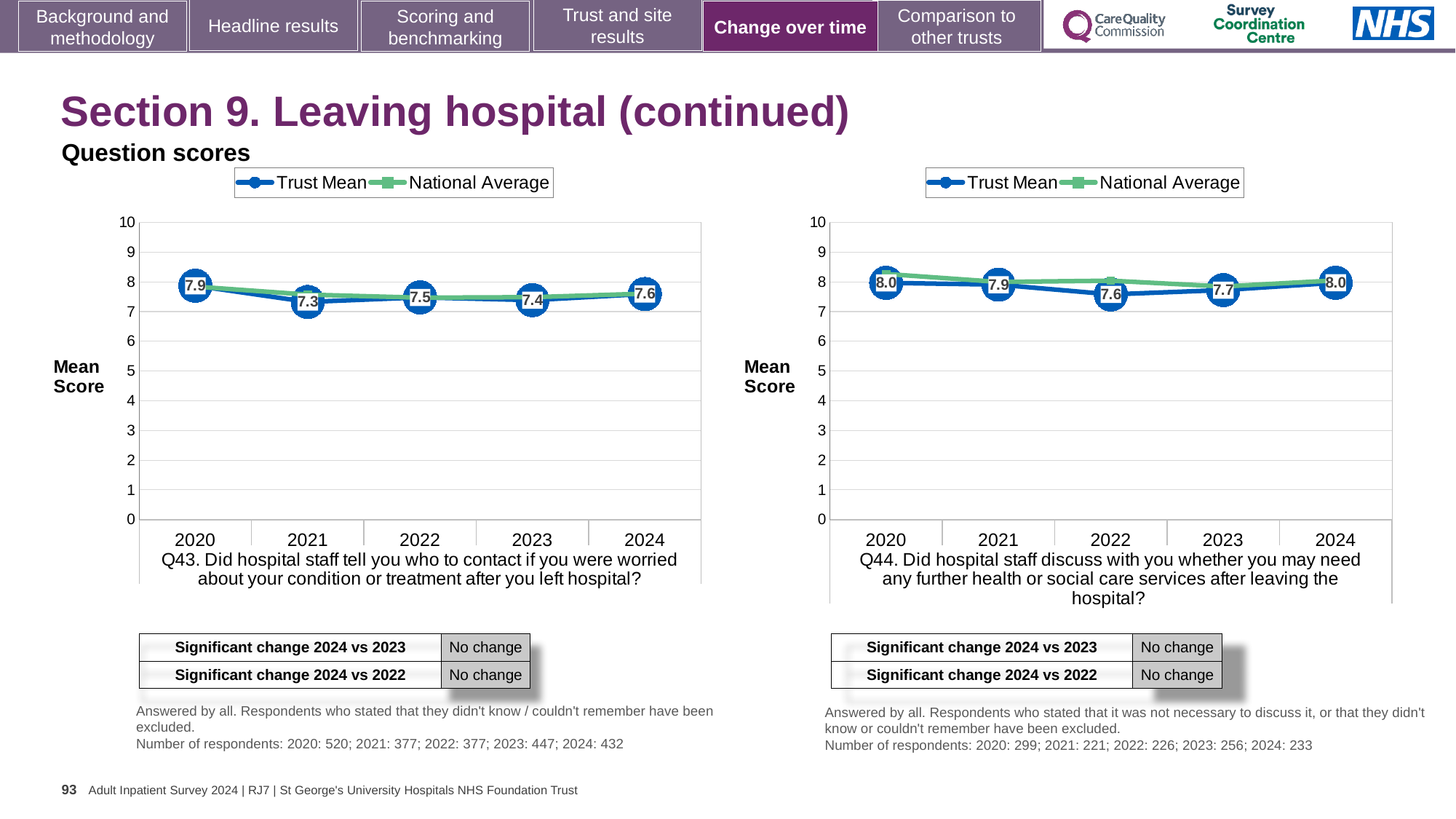
In the Q44 chart (right), which year has the lowest Trust Mean score? 2022 In the Q44 chart (right), what is the Trust Mean score for 2022? 7.6 In the Q43 chart (left), what is the Trust Mean score for 2020? 7.9 How many series does the legend of the Q44 chart (right) list? 2 In the Q43 chart (left), what is the Trust Mean score for 2021? 7.3 In the Q44 chart (right), is the Trust Mean score for 2023 greater or less than the score for 2024? less In the Q43 chart (left), what is the difference between the Trust Mean scores for 2020 and 2021? 0.6 In the Q43 chart (left), which year has the highest Trust Mean score? 2020 In the Q43 chart (left), which year has the lowest Trust Mean score? 2021 In the Q44 chart (right), what is the Trust Mean score for 2024? 8.0 What type of chart is used for the Q43 chart (left)? Line chart How many years are plotted on the x axis of the Q43 chart (left)? 5